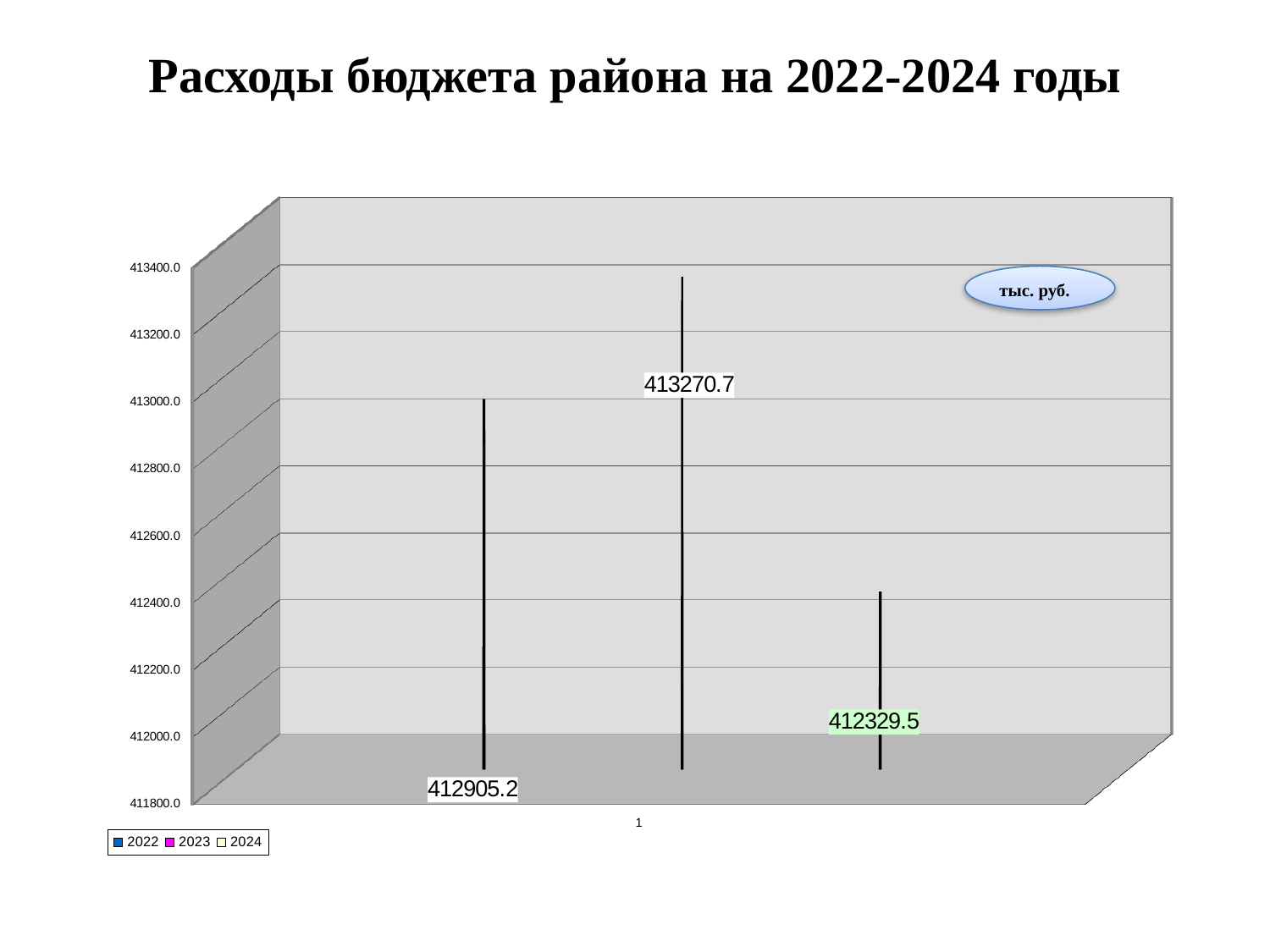
Which year has the highest value? 2023 What is the difference between the values for 2023 and 2022? 365.5 What is the value for 2023? 413270.7 How many series does the legend list? 3 What kind of chart is shown on the slide? bar chart What is the value for 2022? 412905.2 What is the title of the chart? Расходы бюджета района на 2022-2024 годы Is the value for 2023 greater or less than 413000.0? greater Which is larger, the value for 2022 or the value for 2024? 2022 Which year has the lowest value? 2024 What is the difference between the values for 2022 and 2024? 575.7 What is the value for 2024? 412329.5